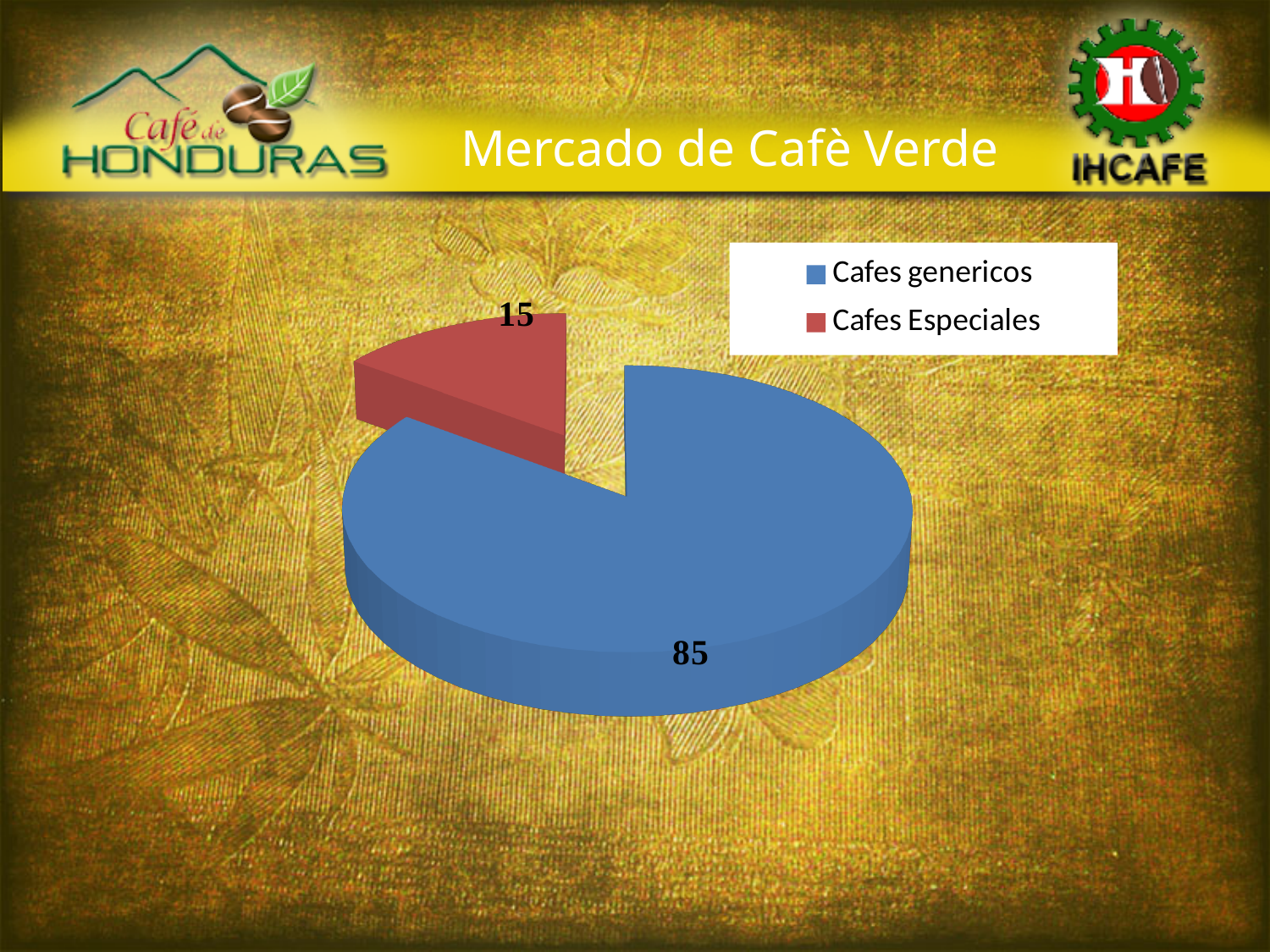
What is the value for Cafes Especiales? 15 What is the difference between the values for Cafes genericos and Cafes Especiales? 70 What is the title of the slide containing the chart? Mercado de Cafè Verde Which is larger, the value for Cafes genericos or Cafes Especiales? Cafes genericos Which category has the smallest slice of the pie? Cafes Especiales What share of the pie does Cafes Especiales represent? 15 Which category has the largest slice of the pie? Cafes genericos How many entries does the legend list? 2 What is the value for Cafes genericos? 85 How many categories does the pie chart show? 2 What kind of chart is shown on the slide? Pie chart What colour is the Cafes Especiales slice? Red